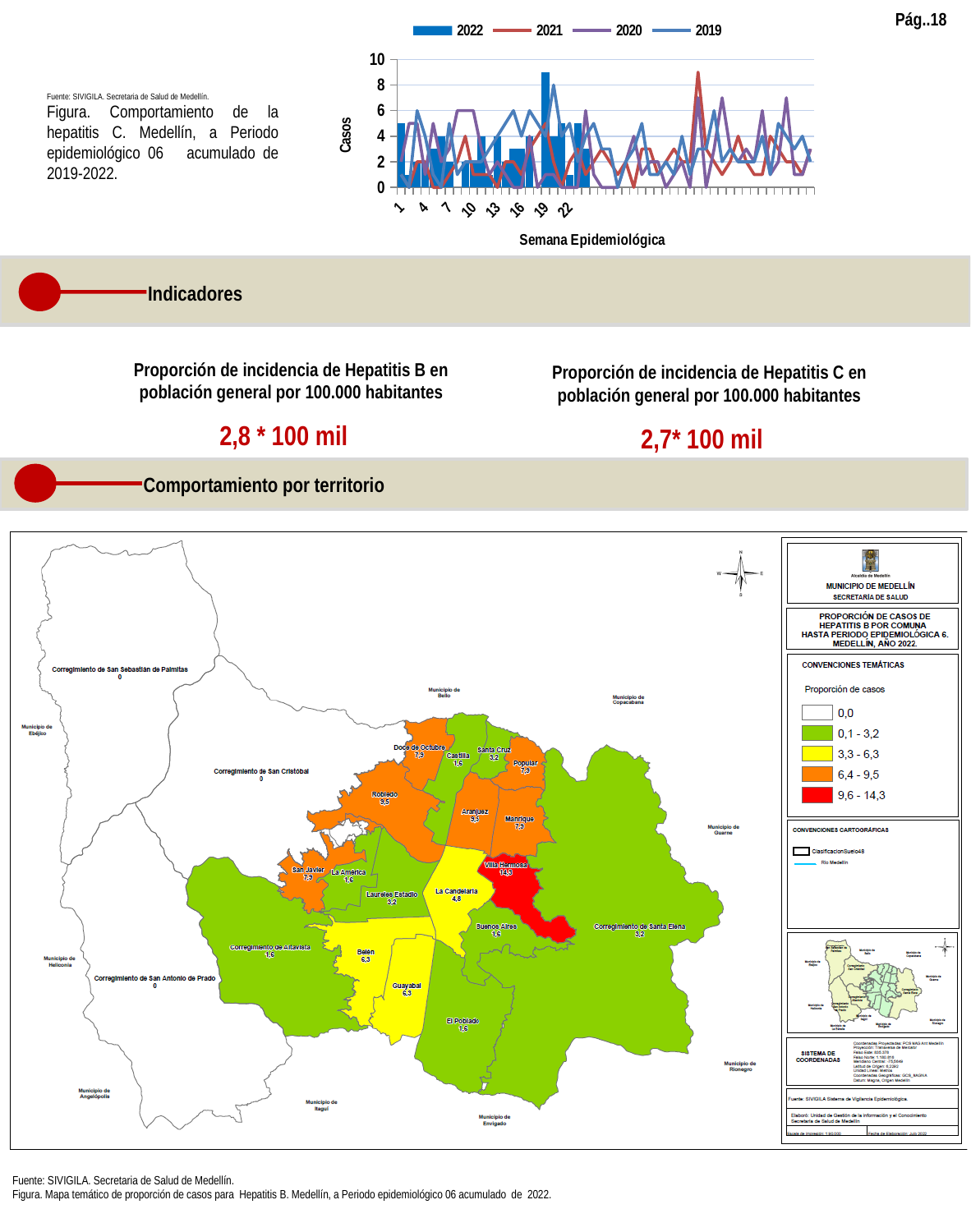
In the top chart, at which epidemiological week does the 2022 series reach its highest bar? 19 In the top chart, which series is drawn as bars rather than a line? 2022 On the map of Hepatitis B proportion by comuna, which has the larger value, Robledo or Castilla? Robledo On the map of Hepatitis B proportion by comuna, what is the value shown for Villa Hermosa? 14,3 Which series are listed in the legend of the top chart? 2022, 2021, 2020, 2019 In the top chart, is the 2022 value at week 19 greater or less than 8? greater On the map of Hepatitis B proportion by comuna, what is the difference between the values for Villa Hermosa and Robledo? 4,8 How many series does the legend of the top chart list? 4 In the top chart, is the peak value of the 2021 line greater or less than 8? greater On the map of Hepatitis B proportion by comuna, what is the value shown for Robledo? 9,5 What kind of chart is the top chart on the slide (Comportamiento de la hepatitis C)? A combined bar and line chart On the map of Hepatitis B proportion by comuna, which comuna has the highest proportion of cases? Villa Hermosa